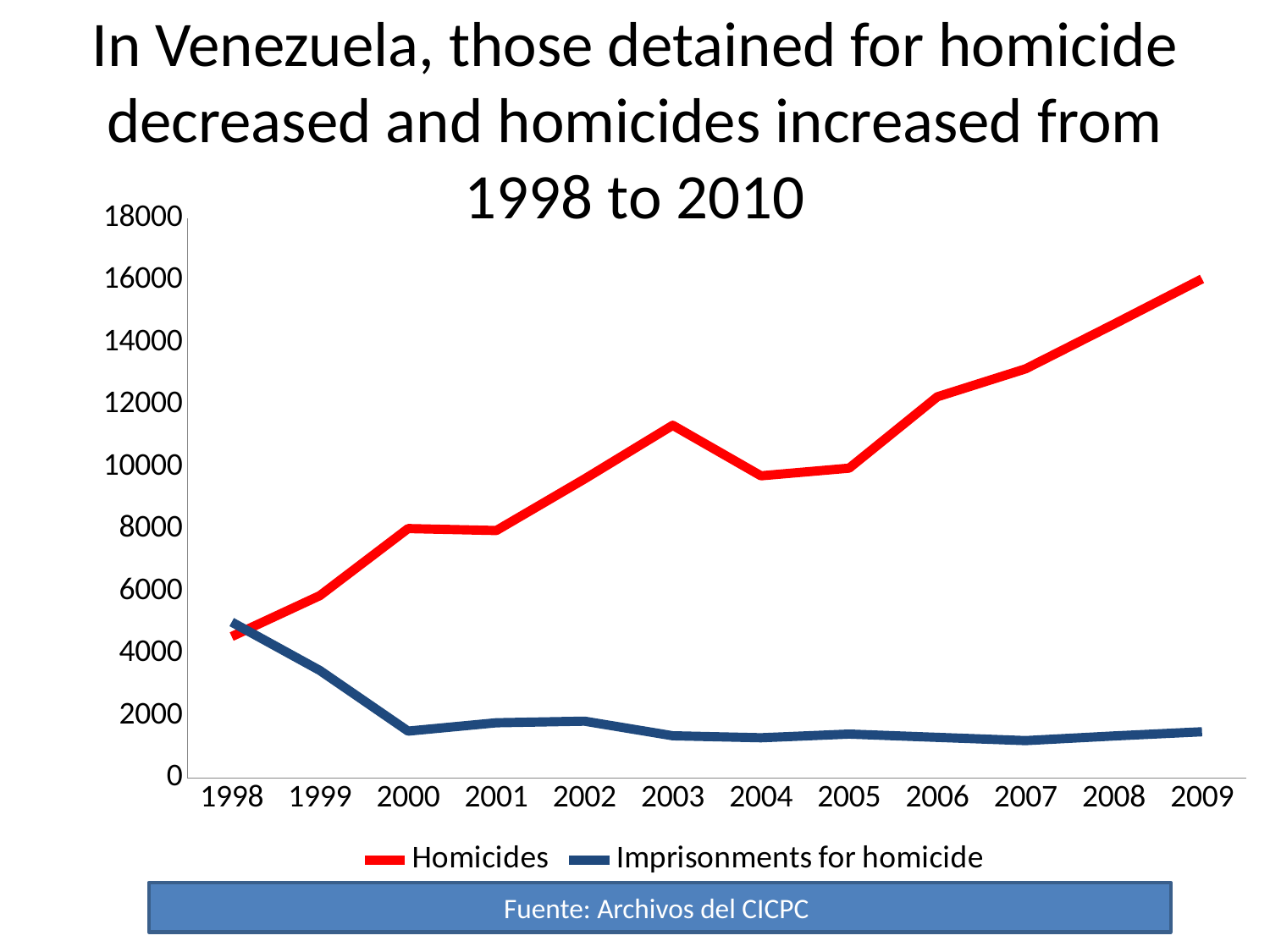
What colour is the line for Imprisonments for homicide? blue Do the values for Imprisonments for homicide rise or fall from 1998 to 2000? fall How many years are plotted along the x axis? 12 In which year is the value for Homicides highest? 2009 How many series does the legend list? 2 In which year is the value for Homicides lowest? 1998 Which series has the larger value in 2009, Homicides or Imprisonments for homicide? Homicides Is the value for Homicides in 2009 greater or less than 14000? greater Do the values for Homicides generally rise or fall from 1998 to 2009? rise What kind of chart is shown on the slide? line chart Is the value for Imprisonments for homicide in 2000 greater or less than 2000? less In which year is the value for Imprisonments for homicide highest? 1998